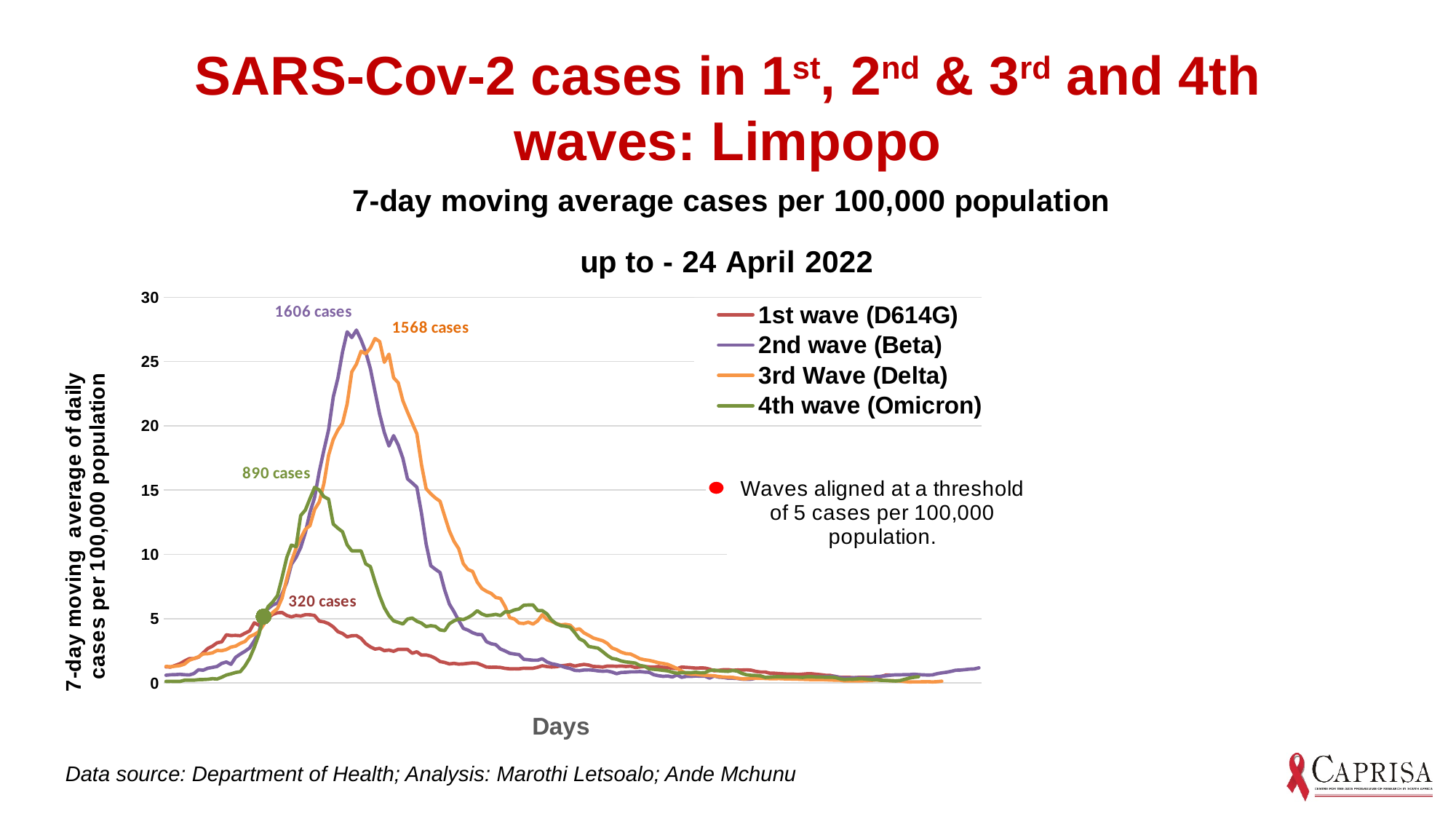
How many cases are labelled at the peak of the 3rd Wave (Delta)? 1568 cases How many cases are labelled at the peak of the 1st wave (D614G)? 320 cases Is the peak value of the 1st wave (D614G) greater or less than 10 cases per 100,000 population? less What is the difference between the labelled peak cases of the 2nd wave (Beta) and the 3rd Wave (Delta)? 38 cases What is the label of the x axis? Days What is the difference between the labelled peak cases of the 4th wave (Omicron) and the 1st wave (D614G)? 570 cases How many cases are labelled at the peak of the 4th wave (Omicron)? 890 cases Which wave has the lowest peak in the chart? 1st wave (D614G) Is the peak value of the 2nd wave (Beta) greater or less than 25 cases per 100,000 population? greater How many cases are labelled at the peak of the 2nd wave (Beta)? 1606 cases What kind of chart is shown on the slide? Line chart How many series does the legend list? 4